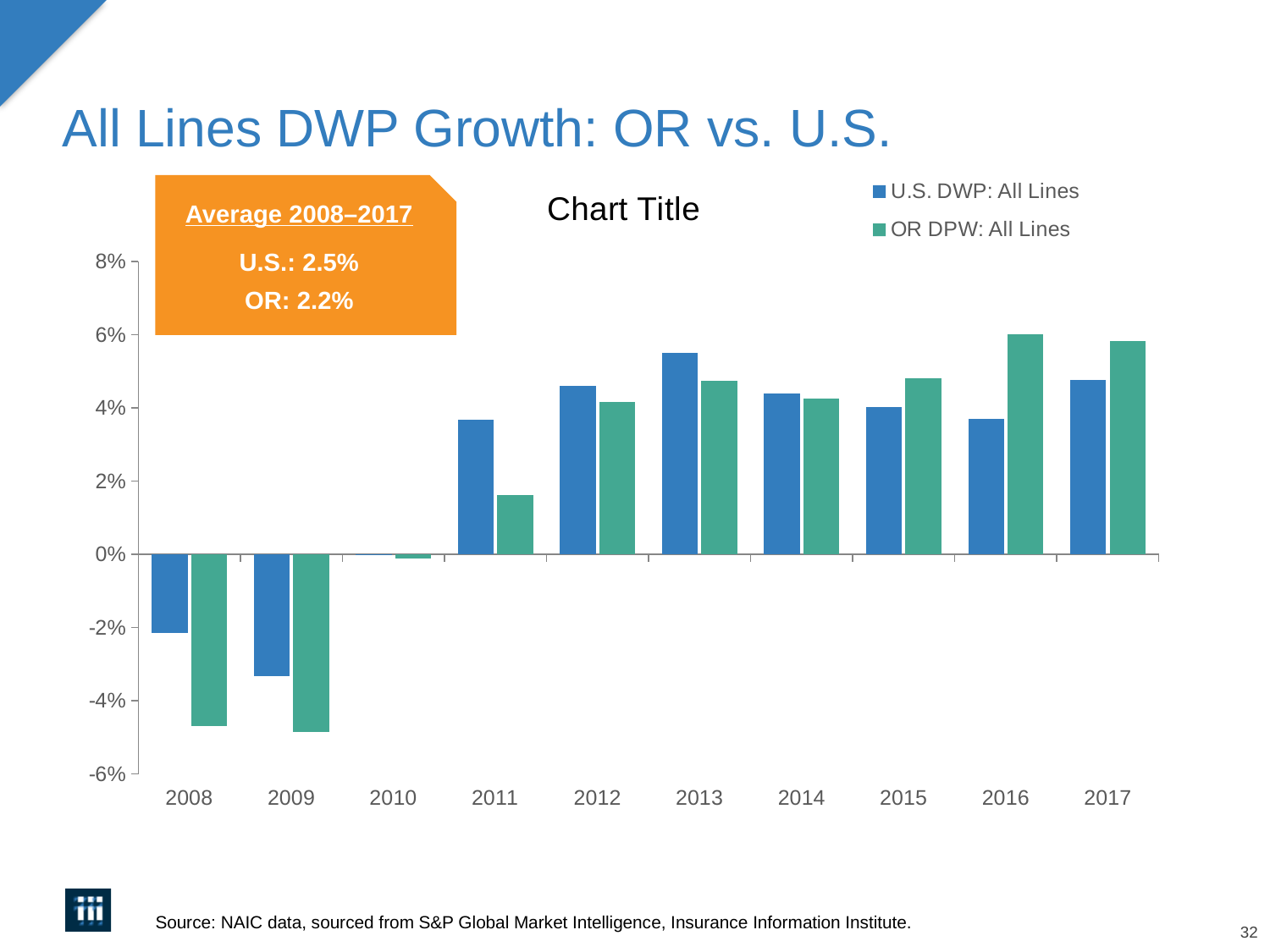
How many series does the legend list? 2 In which year is U.S. DWP: All Lines growth highest? 2013 According to the box on the slide, what is the U.S. average DWP growth for 2008–2017? 2.5% Is the value for OR DPW: All Lines in 2011 greater or less than 2%? less Is the value for U.S. DWP: All Lines in 2013 greater or less than 4%? greater In 2016, which is larger: U.S. DWP: All Lines or OR DPW: All Lines? OR DPW: All Lines What kind of chart is shown on the slide? bar chart In 2011, which is larger: U.S. DWP: All Lines or OR DPW: All Lines? U.S. DWP: All Lines In which year is U.S. DWP: All Lines growth lowest? 2009 According to the box on the slide, what is the OR average DWP growth for 2008–2017? 2.2% Is the value for OR DPW: All Lines in 2008 greater or less than -4%? less How many years are shown on the x axis? 10